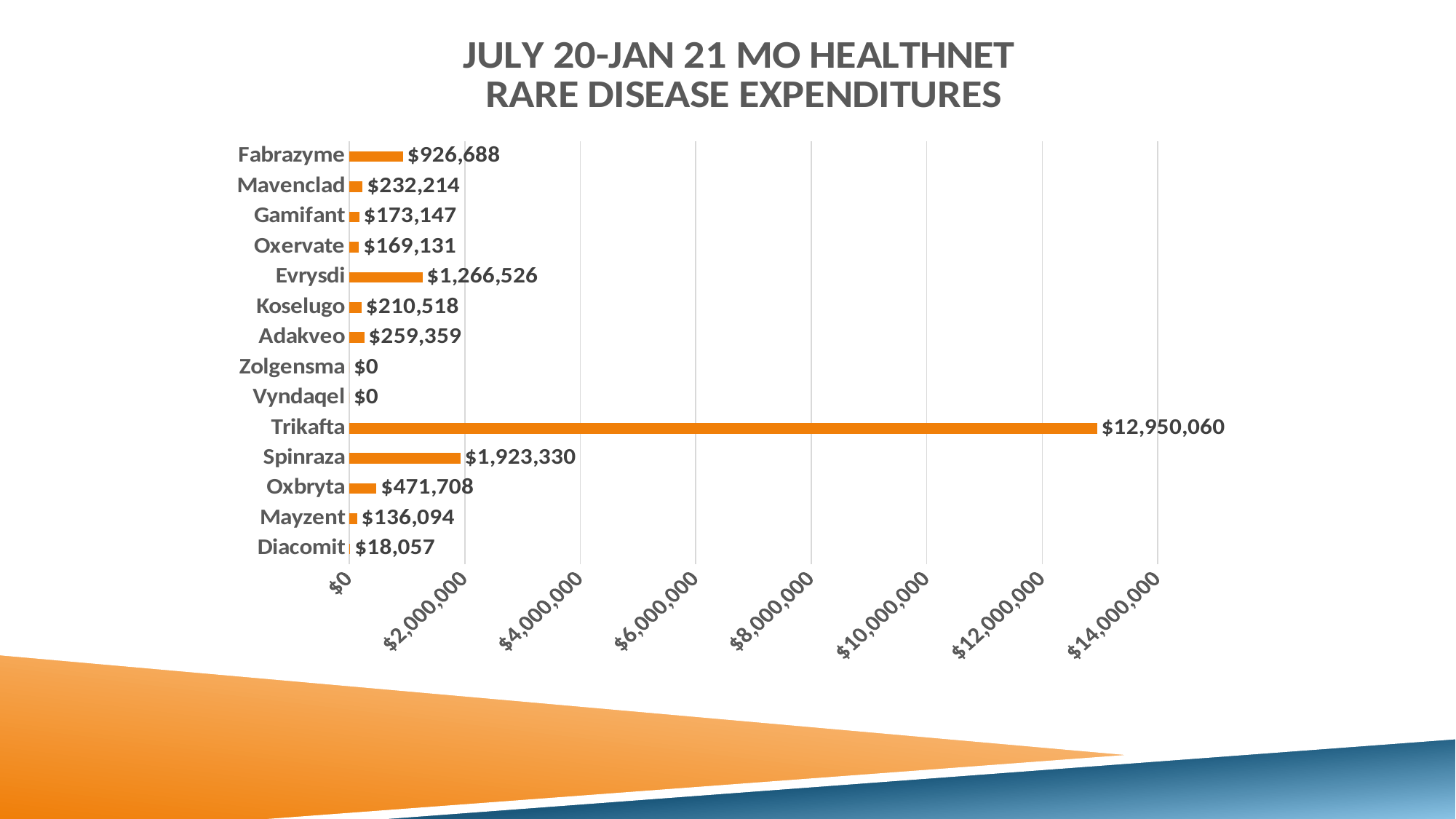
What is the difference between the expenditures for Spinraza and Evrysdi? $656,804 What is the title of the chart? JULY 20-JAN 21 MO HEALTHNET RARE DISEASE EXPENDITURES Which has a larger expenditure, Mavenclad or Adakveo? Adakveo Is the value for Trikafta greater or less than $12,000,000? greater Which two drugs show an expenditure of $0? Zolgensma and Vyndaqel Which drug has the highest expenditure? Trikafta What type of chart is shown on the slide? bar chart How many drugs are listed on the chart? 14 What is the expenditure for Trikafta? $12,950,060 What is the expenditure for Spinraza? $1,923,330 What is the difference between the expenditures for Fabrazyme and Oxbryta? $454,980 What is the expenditure for Diacomit? $18,057